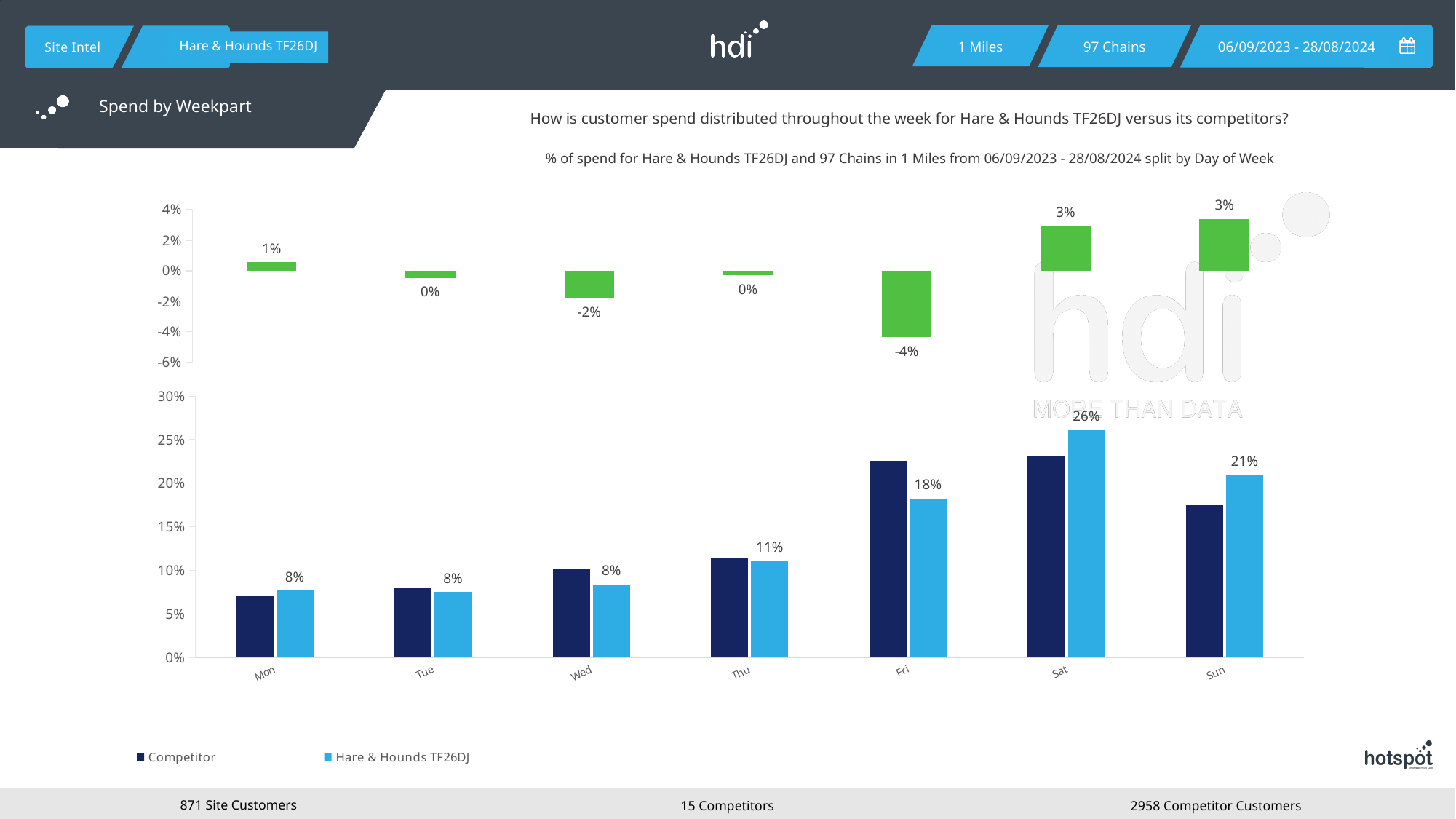
How many series does the legend of the bottom bar chart list? 2 In the bottom bar chart, which is larger on Sun: the Competitor value or the Hare & Hounds TF26DJ value? Hare & Hounds TF26DJ In the bottom bar chart, what is the value for Hare & Hounds TF26DJ on Thu? 11% In the top chart, which day has the lowest value? Fri In the bottom bar chart, which day has the highest value for Hare & Hounds TF26DJ? Sat In the bottom bar chart, what is the value for Hare & Hounds TF26DJ on Fri? 18% How many days of the week are shown on the x axis of the bottom bar chart? 7 In the bottom bar chart, is the Competitor value for Mon greater or less than 10%? less In the bottom bar chart, what is the value for Hare & Hounds TF26DJ on Sat? 26% In the top chart, what is the value shown for Fri? -4% In the bottom bar chart, is the Competitor value for Fri greater or less than 20%? greater In the bottom bar chart, what is the difference between the Hare & Hounds TF26DJ values for Sat and Sun? 5%